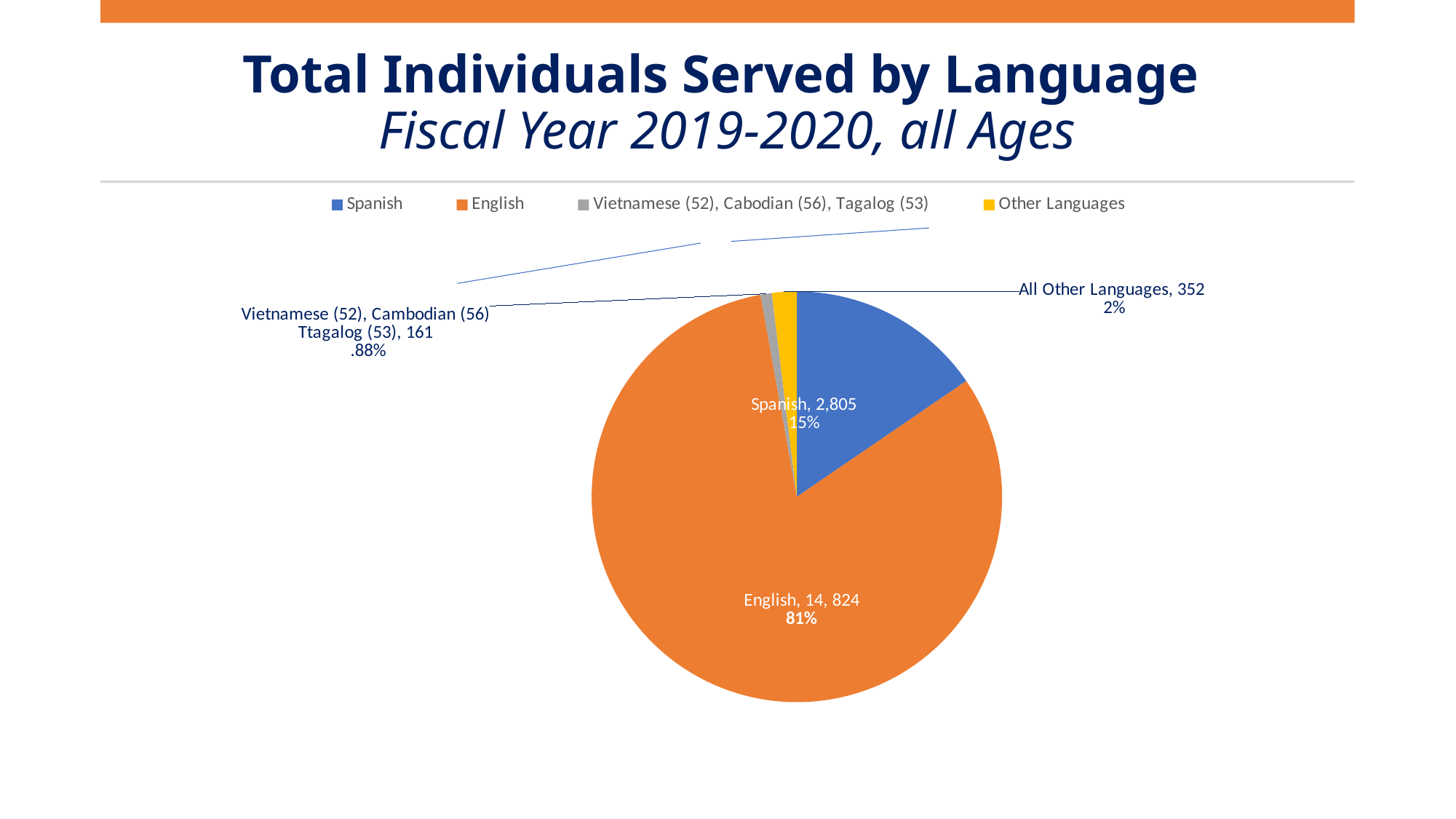
How many individuals were served in English? 14, 824 How many entries does the legend list? 4 What share of the pie does English represent? 81% What share of the pie does the Vietnamese, Cambodian, Tagalog slice represent? .88% How many individuals were served in Spanish? 2,805 What type of chart is shown on the slide? Pie chart How many individuals are in the All Other Languages slice? 352 Which legend entry is shown in yellow? Other Languages What share of the pie does Spanish represent? 15% How many more individuals were served in Spanish than in All Other Languages? 2,453 Which slice of the pie is the smallest? Vietnamese (52), Cambodian (56), Ttagalog (53) Which language has the largest slice of the pie? English